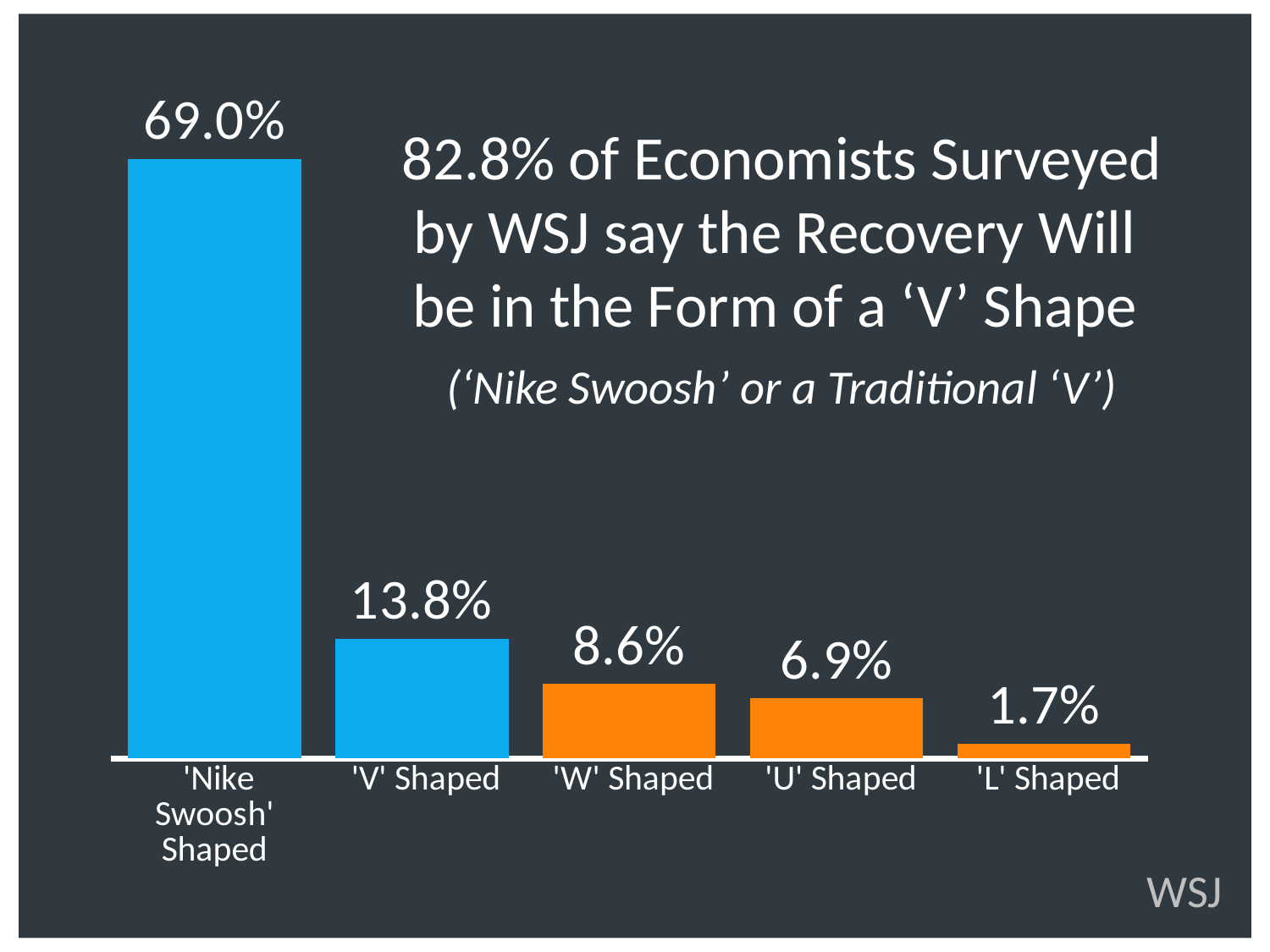
What is the difference in percentage points between 'W' Shaped and 'U' Shaped? 1.7 What percentage of economists said the recovery will be 'Nike Swoosh' shaped? 69.0% Which is larger, the value for 'U' Shaped or the value for 'L' Shaped? 'U' Shaped What is the value shown for 'L' Shaped? 1.7% What type of chart is shown on the slide? Bar chart Which bars are coloured blue rather than orange? 'Nike Swoosh' Shaped and 'V' Shaped What is the value shown for 'V' Shaped? 13.8% How many recovery shape categories are shown in the chart? 5 Which recovery shape has the highest percentage? 'Nike Swoosh' Shaped What is the value shown for 'W' Shaped? 8.6% Which recovery shape has the lowest percentage? 'L' Shaped What is the difference in percentage points between 'Nike Swoosh' Shaped and 'V' Shaped? 55.2